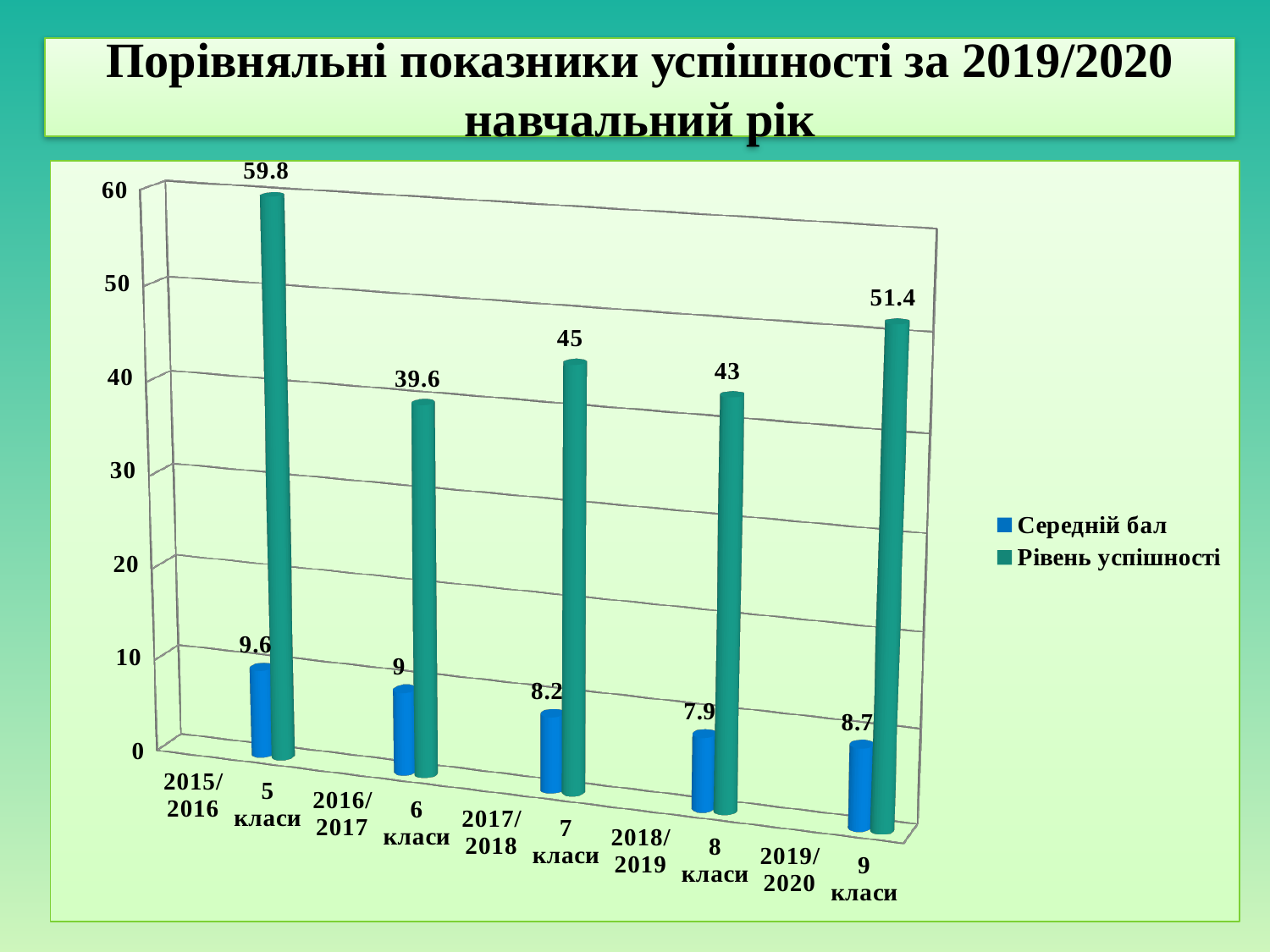
What is the value of Рівень успішності for 2015/2016 (5 класи)? 59.8 Is the Рівень успішності for 2019/2020 (9 класи) greater or less than 50? greater What is the difference between the Рівень успішності for 2015/2016 and 2016/2017? 20.2 Which school year has the lowest Середній бал? 2018/2019 (8 класи) What is the value of Рівень успішності for 2019/2020 (9 класи)? 51.4 How many series does the legend list? 2 Which school year has the highest Рівень успішності? 2015/2016 (5 класи) Which school year has the lowest Рівень успішності? 2016/2017 (6 класи) Which is larger: the Рівень успішності for 2017/2018 (7 класи) or for 2018/2019 (8 класи)? 2017/2018 (7 класи) How many school years are shown on the x axis? 5 What is the value of Середній бал for 2018/2019 (8 класи)? 7.9 What kind of chart is shown on the slide? bar chart